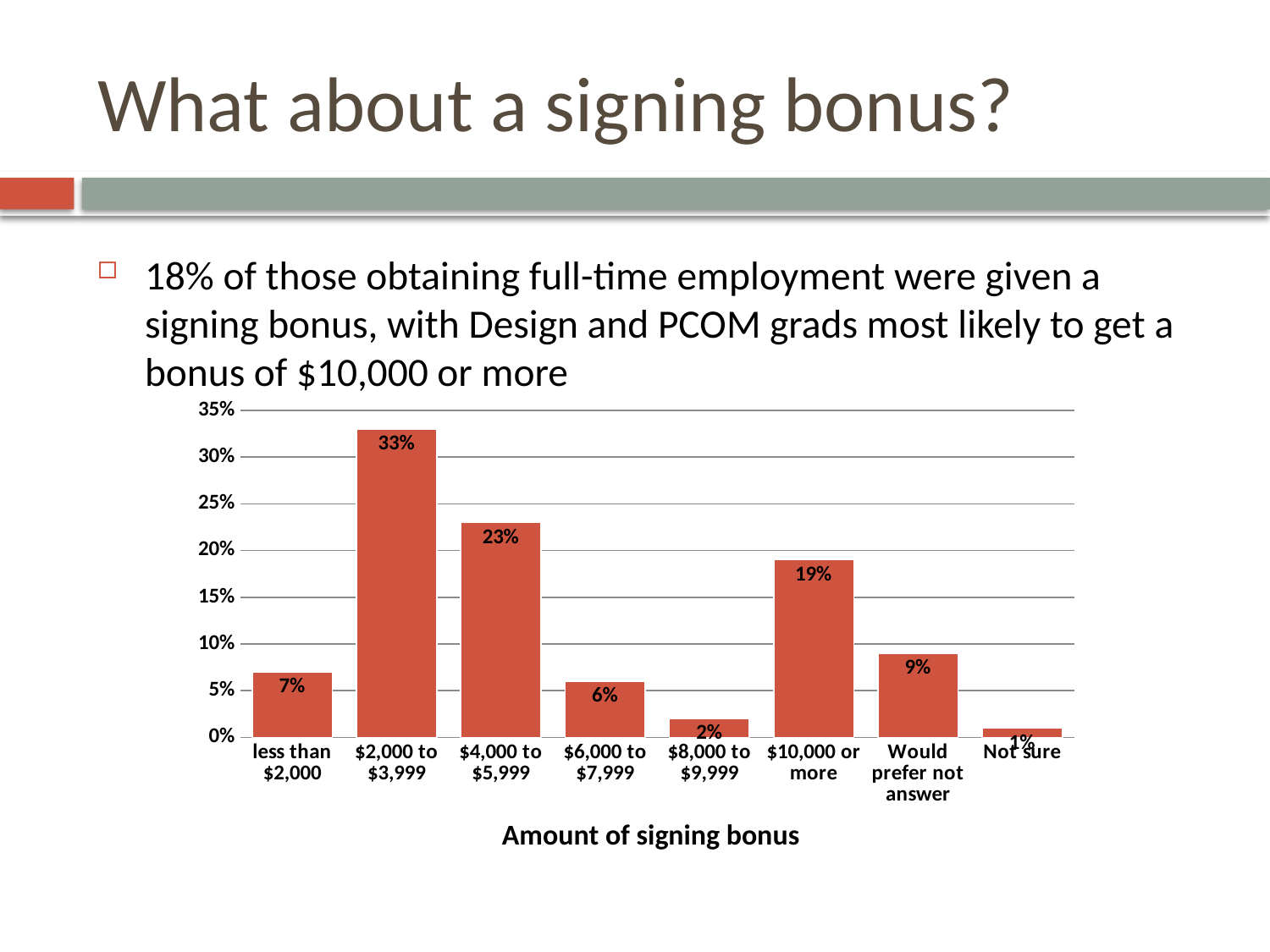
What is the difference between the "$2,000 to $3,999" and "$4,000 to $5,999" categories? 10% What is the x-axis title of the chart? Amount of signing bonus What percentage of respondents would prefer not to answer? 9% What percentage of respondents received a signing bonus of $2,000 to $3,999? 33% How many categories are shown on the x axis? 8 Which is larger: the value for "less than $2,000" or the value for "$6,000 to $7,999"? less than $2,000 Which signing bonus category has the highest percentage? $2,000 to $3,999 What is the highest value shown on the y axis? 35% What kind of chart is shown on the slide? Bar chart What is the value for the "$10,000 or more" category? 19% What is the value for the "$8,000 to $9,999" category? 2% Which category has the lowest percentage? Not sure